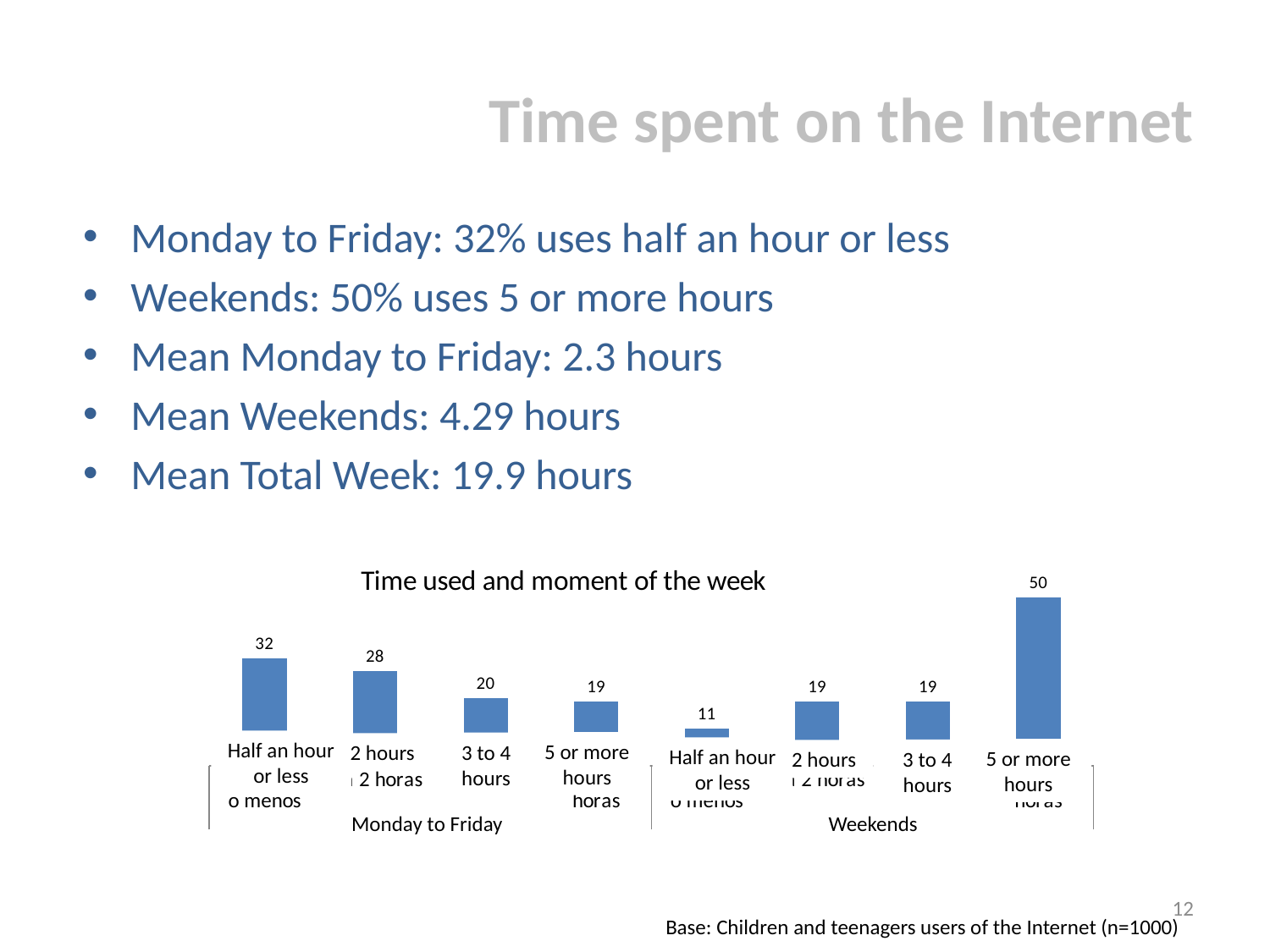
What is the value for '5 or more hours' in the Weekends group? 50 Which is larger: 'Half an hour or less' for Monday to Friday or for Weekends? Monday to Friday How many bars are plotted in the chart? 8 What is the value for '2 hours' in the Monday to Friday group? 28 What is the value for 'Half an hour or less' in the Monday to Friday group? 32 What is the title of the chart? Time used and moment of the week What is the difference between the '5 or more hours' value for Weekends and for Monday to Friday? 31 What is the value for 'Half an hour or less' in the Weekends group? 11 What type of chart is shown on the slide? Bar chart Do the values rise or fall across the four Weekends categories from left to right? Rise Which bar has the highest value in the chart? 5 or more hours (Weekends) Which bar has the lowest value in the chart? Half an hour or less (Weekends)